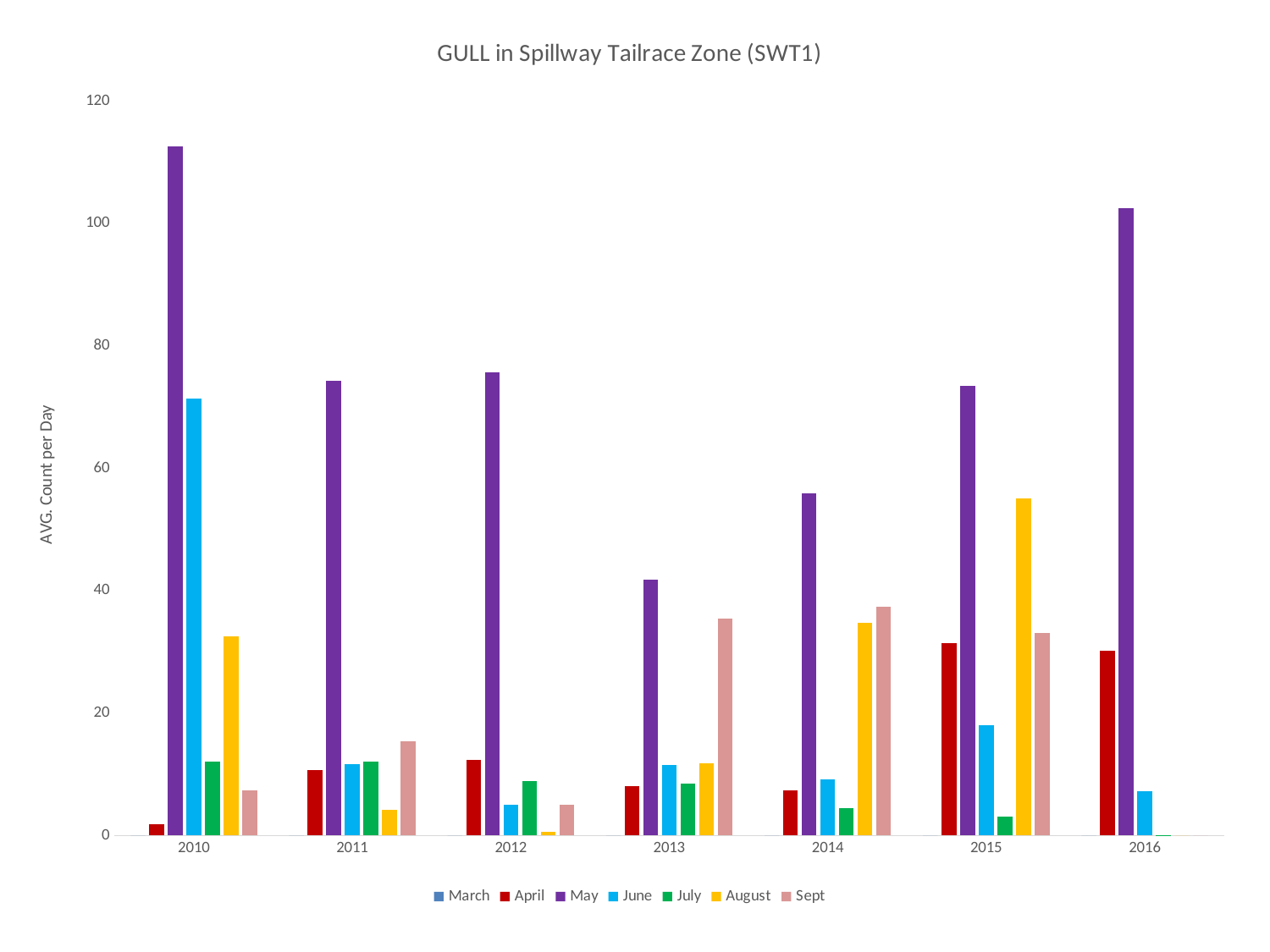
How many series does the legend list? 7 In which year is the May value highest? 2010 Is the May value for 2010 greater or less than 100? greater What kind of chart is shown on the slide? bar chart In which year is the May value lowest? 2013 How many years are shown on the x axis? 7 Is the April value for 2015 greater or less than 20? greater In 2014, which is larger, the May value or the Sept value? May Is the June value for 2010 greater or less than 60? greater In 2015, which is larger, the August value or the Sept value? August What is the title of the chart? GULL in Spillway Tailrace Zone (SWT1)